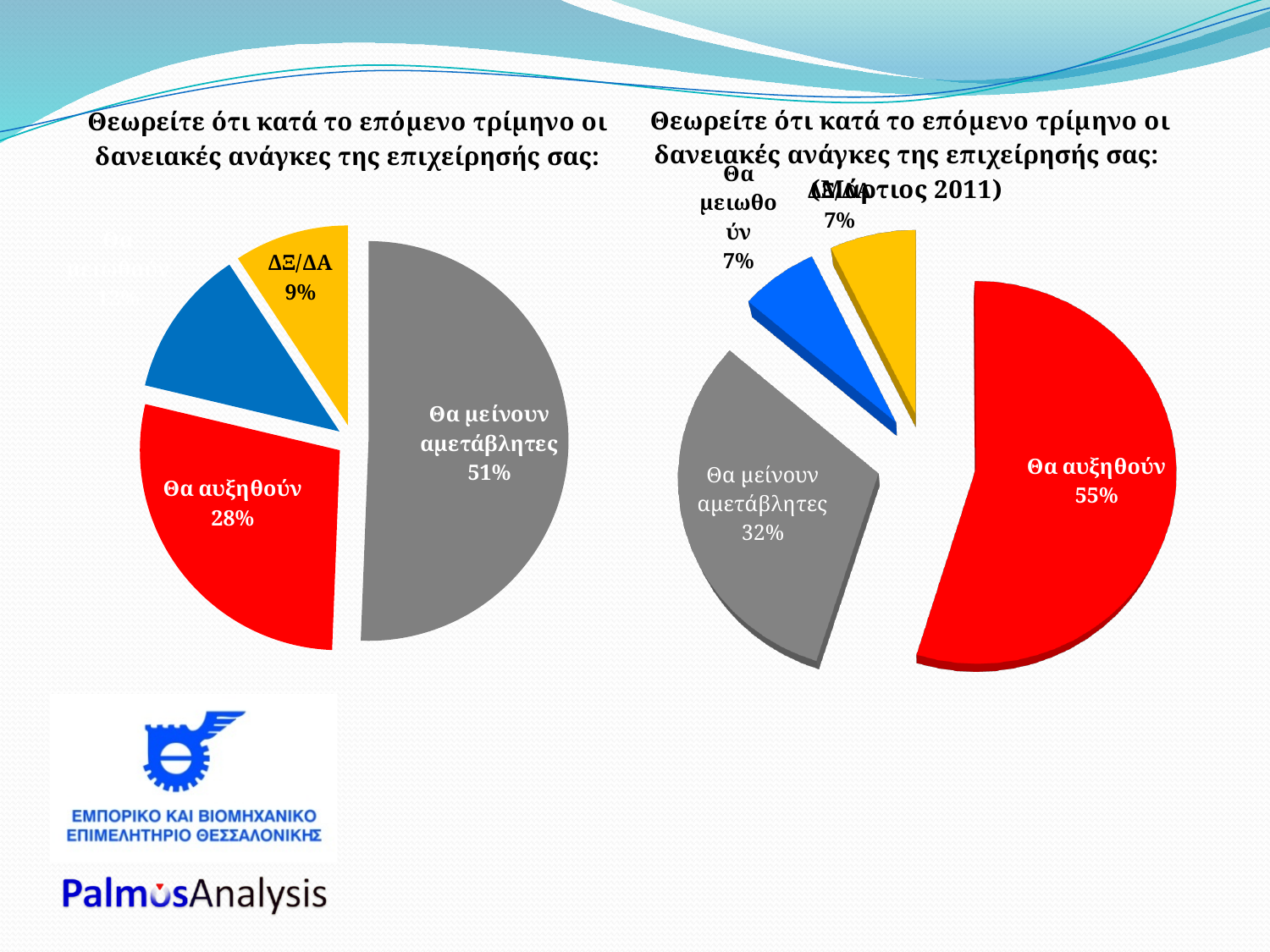
In the right pie chart (Μάρτιος 2011), which category has the largest slice? Θα αυξηθούν In the left pie chart, which category has the largest slice? Θα μείνουν αμετάβλητες What type of chart is used on this slide? pie chart In the right pie chart (Μάρτιος 2011), what is the difference between the 'Θα αυξηθούν' and 'Θα μείνουν αμετάβλητες' shares? 23% In the left pie chart, what share of respondents answered 'Θα μείνουν αμετάβλητες'? 51% In the right pie chart (Μάρτιος 2011), what share of respondents answered 'Θα αυξηθούν'? 55% In the left pie chart, what is the difference between the 'Θα μείνουν αμετάβλητες' and 'Θα αυξηθούν' shares? 23% In the right pie chart (Μάρτιος 2011), what share of respondents answered 'Θα μειωθούν'? 7% Which chart shows a larger share for 'Θα αυξηθούν', the left chart or the right chart (Μάρτιος 2011)? the right chart In the right pie chart (Μάρτιος 2011), what share of respondents answered 'Θα μείνουν αμετάβλητες'? 32% In the left pie chart, what share is labelled 'ΔΞ/ΔΑ'? 9% In the left pie chart, what share of respondents answered 'Θα αυξηθούν'? 28%